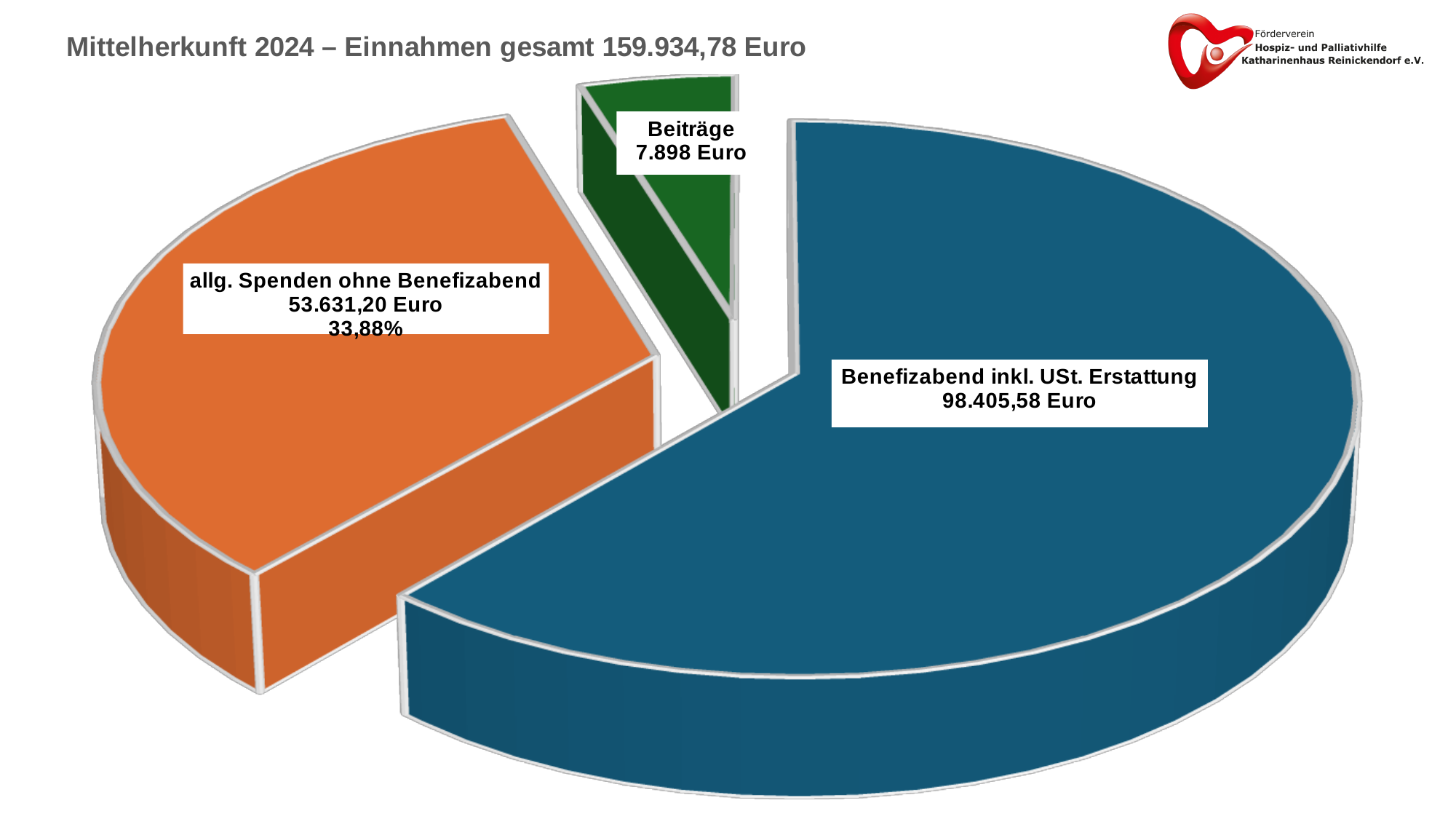
Which category has the smallest slice of the pie? Beiträge What is the difference between allg. Spenden ohne Benefizabend and Beiträge? 45.733,20 Euro What share of the pie does allg. Spenden ohne Benefizabend represent? 33,88% What is the value for Benefizabend inkl. USt. Erstattung? 98.405,58 Euro What is the value for allg. Spenden ohne Benefizabend? 53.631,20 Euro What is the value for Beiträge? 7.898 Euro What is the title of the chart? Mittelherkunft 2024 – Einnahmen gesamt 159.934,78 Euro Which category has the largest slice of the pie? Benefizabend inkl. USt. Erstattung What kind of chart is shown on the slide? pie chart How many slices does the pie chart have? 3 Which is larger, allg. Spenden ohne Benefizabend or Beiträge? allg. Spenden ohne Benefizabend What is the difference between Benefizabend inkl. USt. Erstattung and allg. Spenden ohne Benefizabend? 44.774,38 Euro